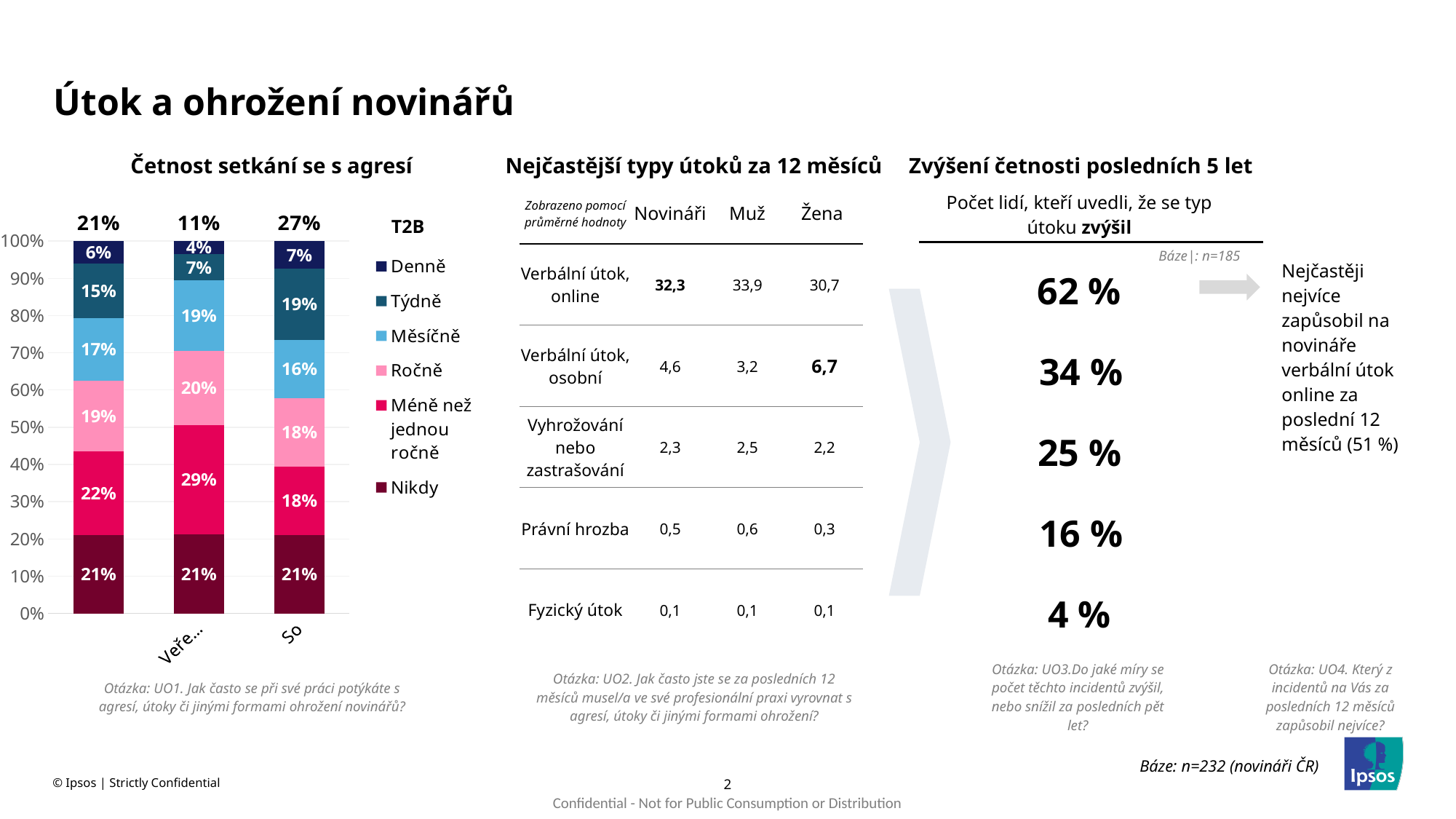
In the "Četnost setkání se s agresí" chart, what is the "Týdně" value in the right-hand bar? 19% What kind of chart is shown under the title "Četnost setkání se s agresí"? Stacked bar chart In the "Četnost setkání se s agresí" chart, is the "Měsíčně" value larger in the left-hand bar or the right-hand bar? Left-hand bar In the "Četnost setkání se s agresí" chart, what is the lowest T2B value printed above the bars? 11% In the "Četnost setkání se s agresí" chart, what is the difference between the "Méně než jednou ročně" value in the middle bar and in the left-hand bar? 7 percentage points In the "Četnost setkání se s agresí" chart, what is the "Ročně" value in the middle bar? 20% In the "Četnost setkání se s agresí" chart, what is the "Denně" value in the middle bar? 4% How many bars are plotted in the "Četnost setkání se s agresí" chart? 3 How many series does the legend of the "Četnost setkání se s agresí" chart list? 6 In the "Četnost setkání se s agresí" chart, what is the "Nikdy" value in the left-hand bar? 21% In the "Četnost setkání se s agresí" chart, what is the highest T2B value printed above the bars? 27% What is the title of the stacked bar chart on the left of the slide? Četnost setkání se s agresí